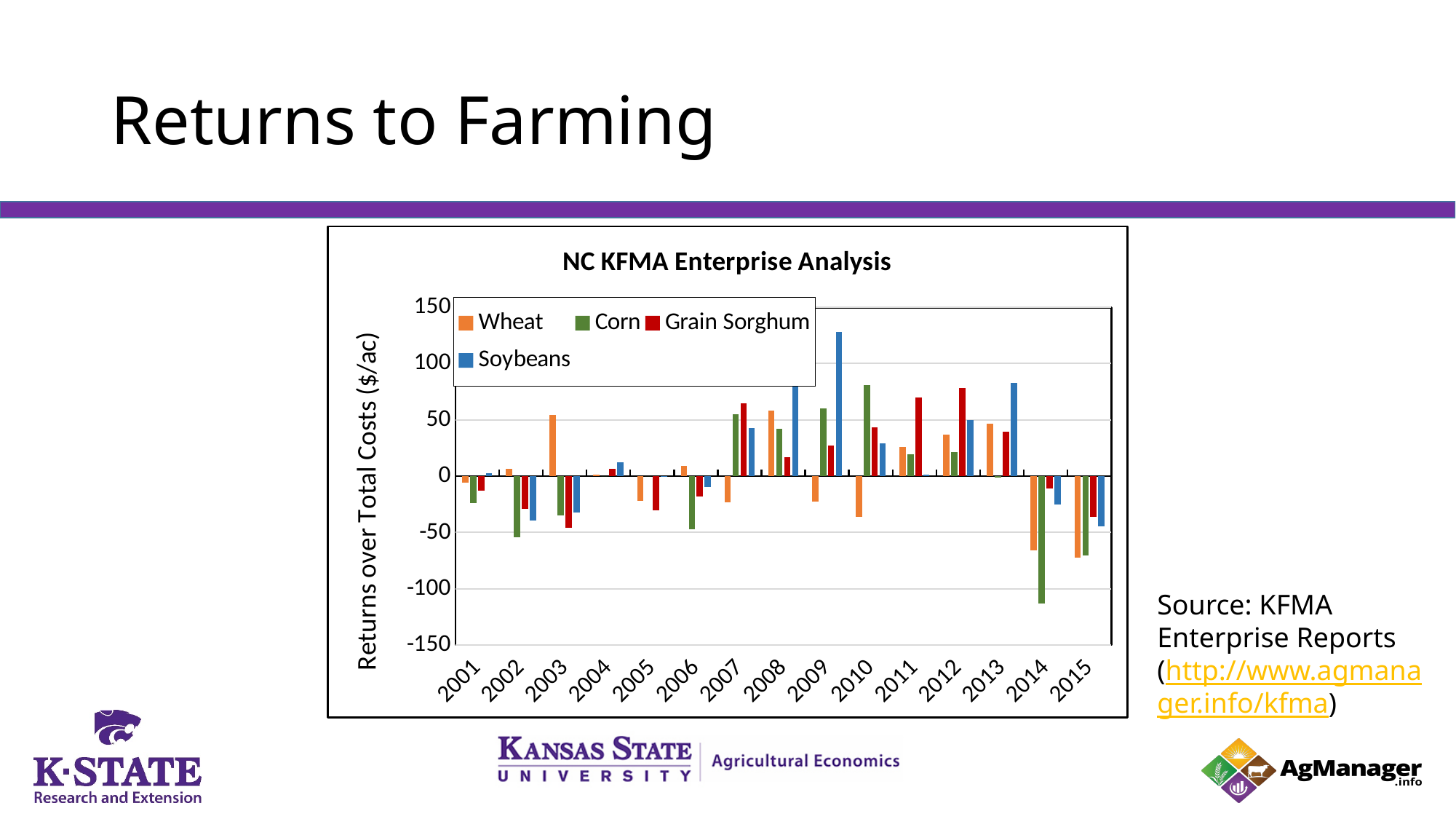
In 2010, which is larger, the value for Corn or the value for Wheat? Corn Which series has the highest value in 2012? Grain Sorghum Is the value for Soybeans in 2009 greater or less than 100? greater What kind of chart is shown on the slide? bar chart In which year does Corn have its lowest return over total costs? 2014 In 2003, which is larger, the value for Wheat or the value for Corn? Wheat Is the value for Corn in 2014 greater or less than -100? less How many years are shown along the x axis of the chart? 15 How many series does the legend of the chart list? 4 What is the title of the chart? NC KFMA Enterprise Analysis In which year does Soybeans reach its highest return over total costs? 2009 Is the value for Grain Sorghum in 2012 greater or less than 50? greater